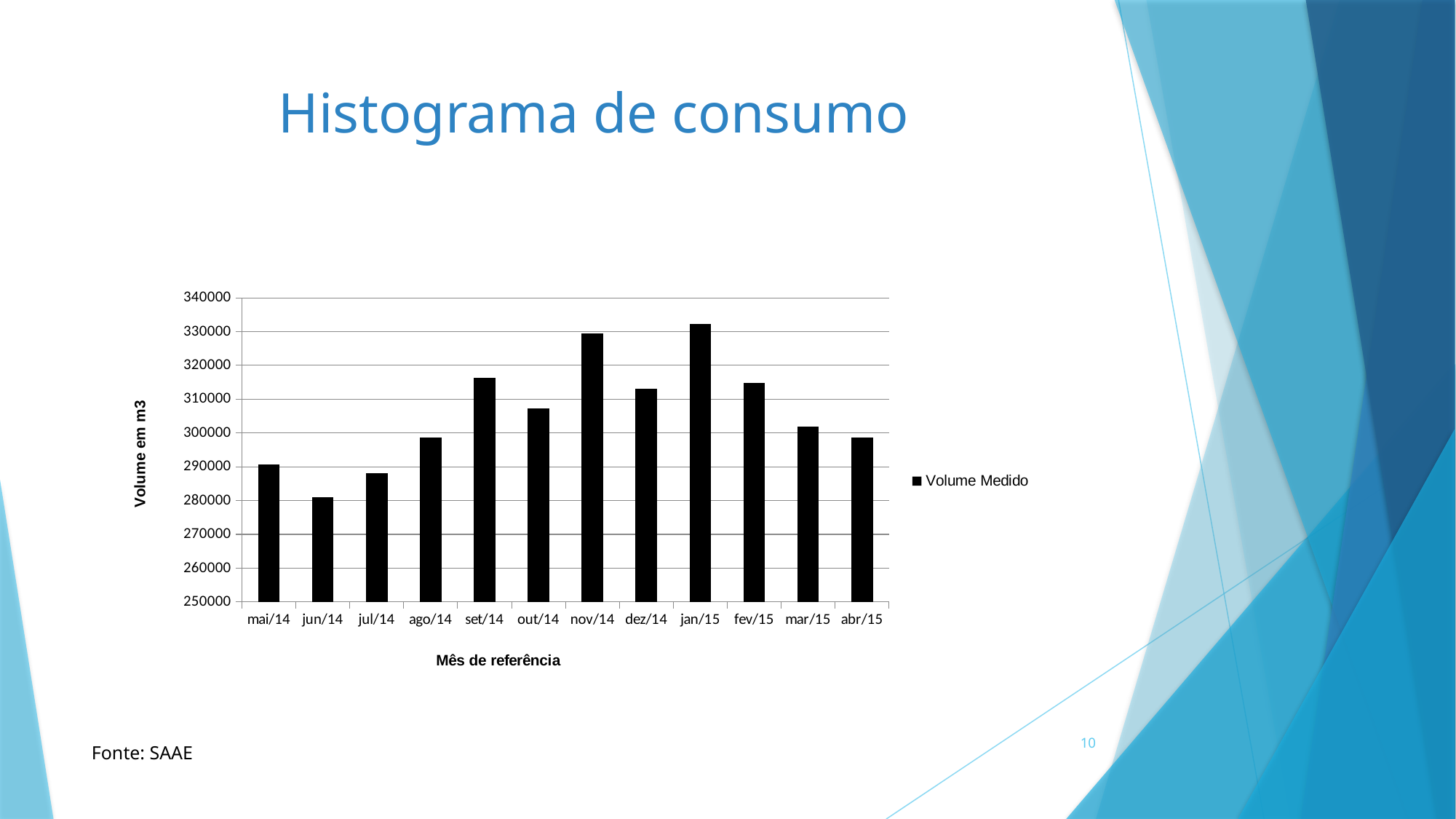
Is the value for nov/14 greater or less than 320000? greater Do the values generally rise or fall from jan/15 to abr/15? fall How many series does the legend list? 1 Which month has the highest measured volume? jan/15 How many months are plotted on the x axis? 12 What is the title of the vertical axis? Volume em m3 Is the value for out/14 greater or less than 300000? greater Is the value for set/14 greater or less than 310000? greater What kind of chart is shown on the slide? Bar chart Which month has the lowest measured volume? jun/14 Which is larger, the value for set/14 or the value for out/14? set/14